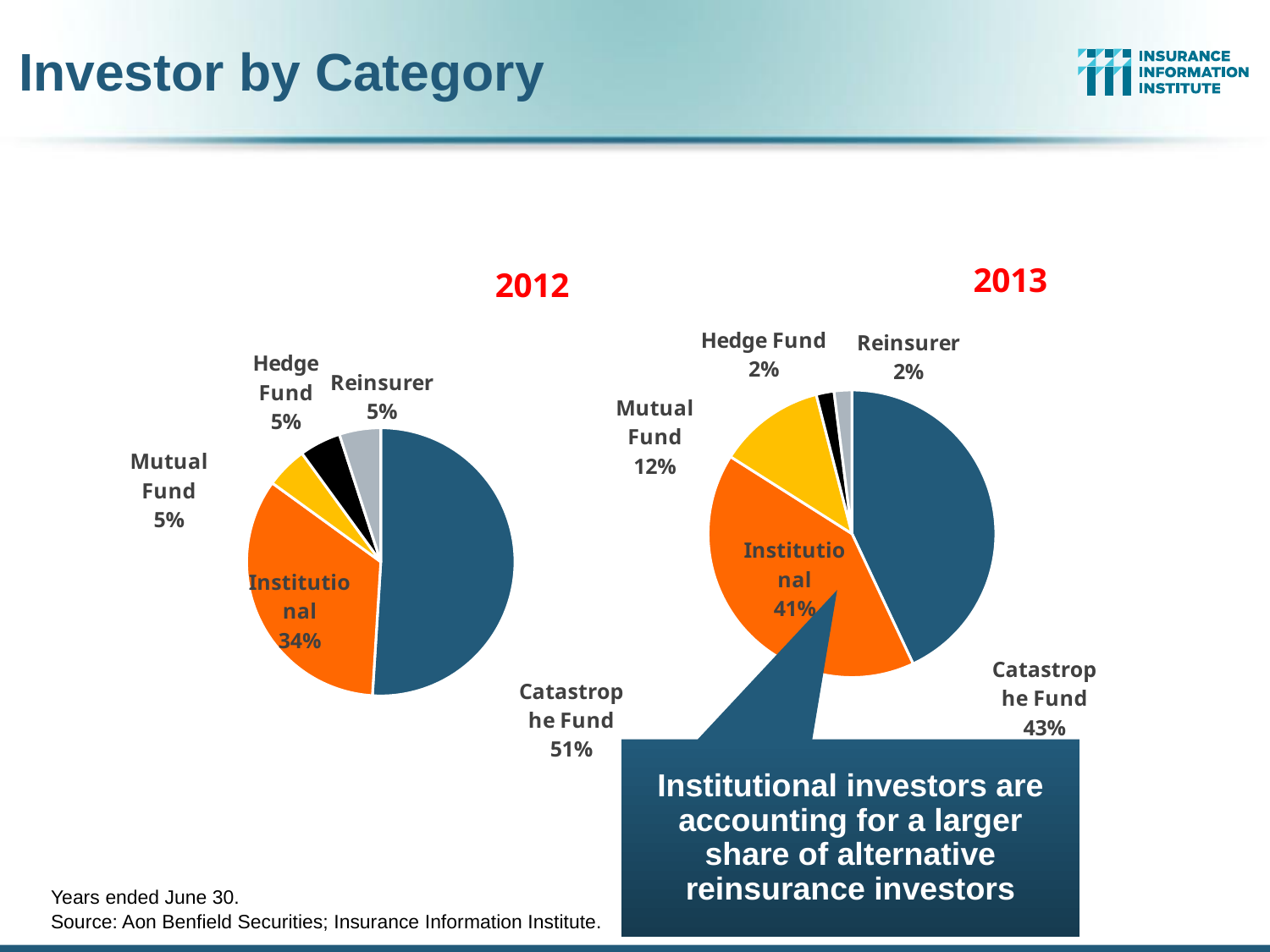
In the 2013 pie chart, what colour is the Institutional slice? Orange What type of chart is used to show investors by category for 2012 and 2013? Pie chart In the 2013 pie chart, what is the share for Mutual Fund? 12% In the 2012 pie chart, what share do Catastrophe Funds account for? 51% In the 2013 pie chart, which category has the largest share? Catastrophe Fund How many categories are shown in the 2013 pie chart? 5 By how many percentage points did the Institutional share increase from the 2012 chart to the 2013 chart? 7 percentage points In the 2013 pie chart, what share do Institutional investors account for? 41% In the 2012 pie chart, which category has the largest share? Catastrophe Fund In the 2012 pie chart, what is the share for Reinsurer? 5% Is the Mutual Fund share larger in the 2012 chart or the 2013 chart? 2013 In the 2013 pie chart, what is the difference between the Catastrophe Fund share and the Institutional share? 2 percentage points